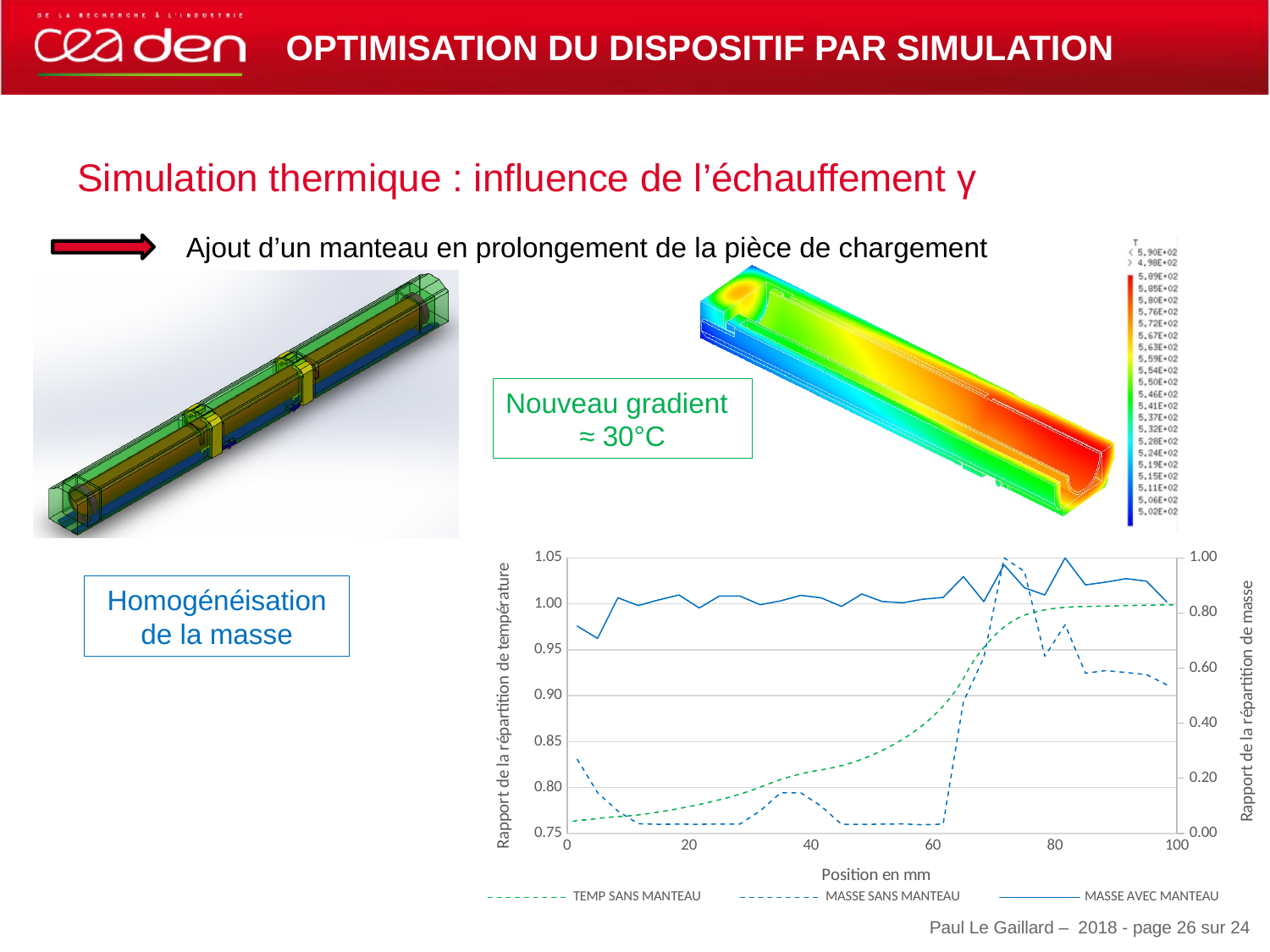
In the line chart, does the TEMP SANS MANTEAU series rise or fall overall as position increases from 0 to 100 mm? rise What is the title of the x axis of the line chart? Position en mm Which series are listed in the legend of the line chart? TEMP SANS MANTEAU, MASSE SANS MANTEAU, MASSE AVEC MANTEAU What is the lowest tick value shown on the right y axis of the line chart? 0.00 What kind of chart is shown at the bottom of the slide? line chart How many tick labels are shown on the x axis of the line chart? 6 What is the highest tick value shown on the left y axis of the line chart? 1.05 In the line chart, does the MASSE SANS MANTEAU series rise or fall between position 60 mm and position 72 mm? rise How many series does the legend of the line chart list? 3 In the line chart, is the value of TEMP SANS MANTEAU at position 0 mm greater or less than 0.80? less In the line chart, is the peak value of MASSE SANS MANTEAU near position 72 mm greater or less than 0.90? greater In the line chart, is the value of MASSE SANS MANTEAU at position 60 mm greater or less than 0.80? less